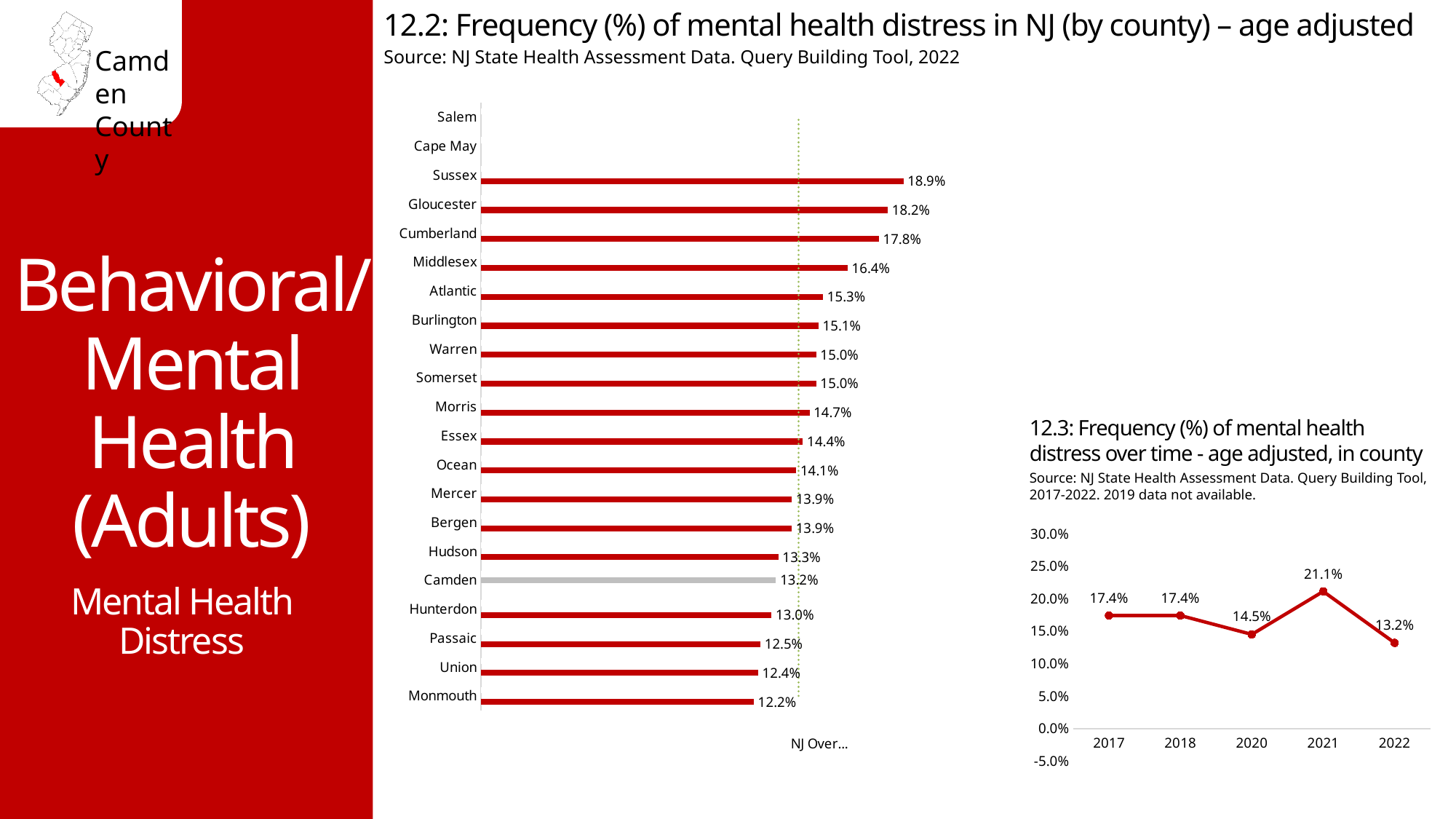
In chart 12.2, which has a larger value, Middlesex or Atlantic? Middlesex In chart 12.2, what is the difference between the values for Sussex and Camden? 5.7% In chart 12.2, what is the value for Camden? 13.2% In chart 12.2, which county has the lowest value among the plotted bars? Monmouth In chart 12.3, which year has the lowest value? 2022 In chart 12.3, what is the difference between the values for 2021 and 2022? 7.9% In chart 12.3, how many data points are plotted? 5 In chart 12.2, what kind of chart is shown? Bar chart In chart 12.3, what is the value for 2021? 21.1% In chart 12.2, what is the value for Gloucester? 18.2% In chart 12.2, which county has the highest value among the plotted bars? Sussex In chart 12.2, which county's bar is shown in grey instead of red? Camden